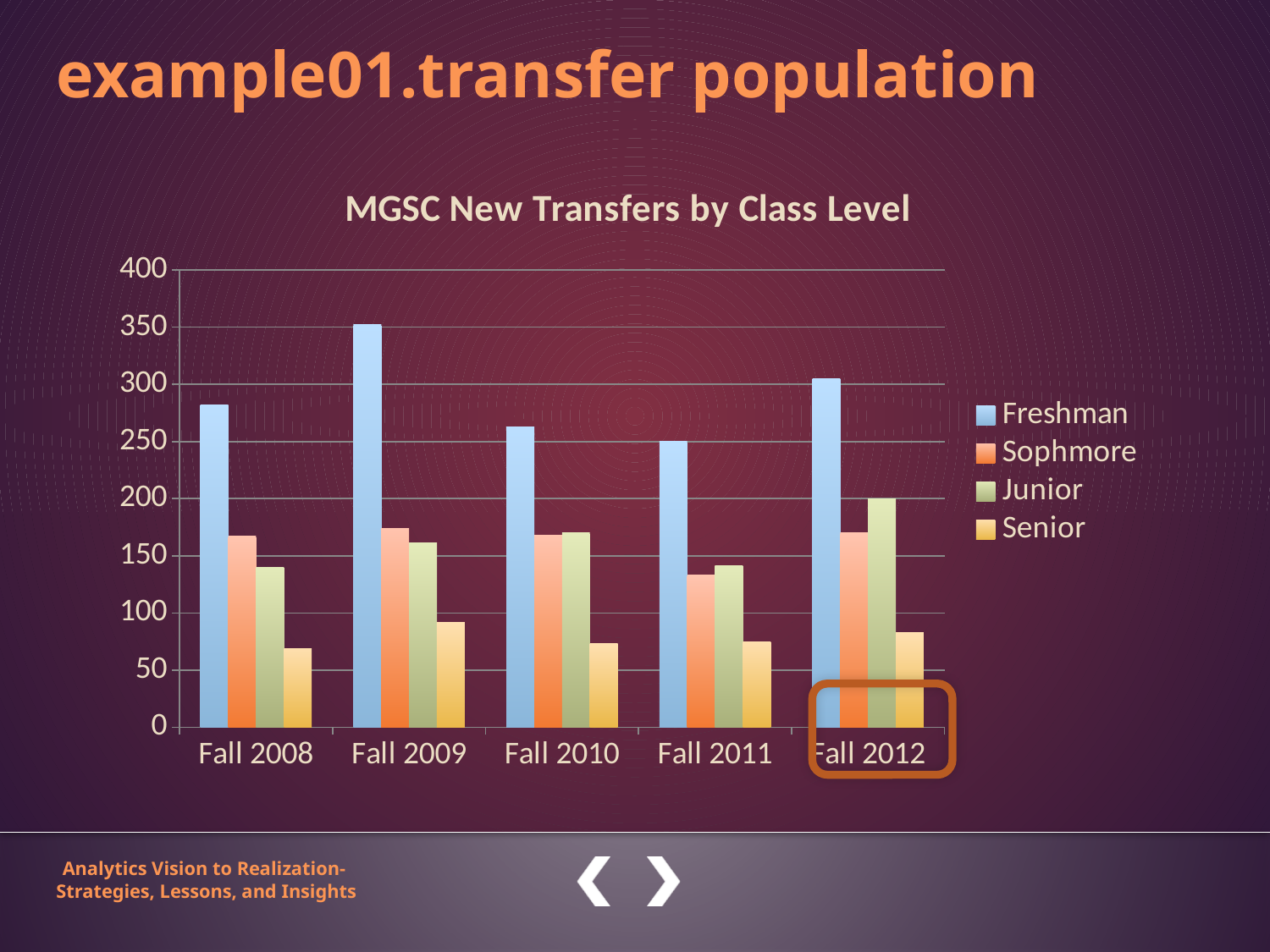
In which semester is the Freshman value lowest? Fall 2011 In which semester is the Freshman value highest? Fall 2009 Which is larger, the Freshman value for Fall 2008 or for Fall 2012? Fall 2012 What is the title of the chart? MGSC New Transfers by Class Level Is the Freshman value for Fall 2011 greater or less than 200? greater How many series does the legend list? 4 In Fall 2012, which is larger, the Sophmore value or the Junior value? Junior How many semesters are shown on the x axis? 5 What kind of chart is shown on the slide? bar chart Which class level has the lowest value in every semester shown? Senior Is the Senior value for Fall 2008 greater or less than 100? less Is the Freshman value for Fall 2009 greater or less than 300? greater